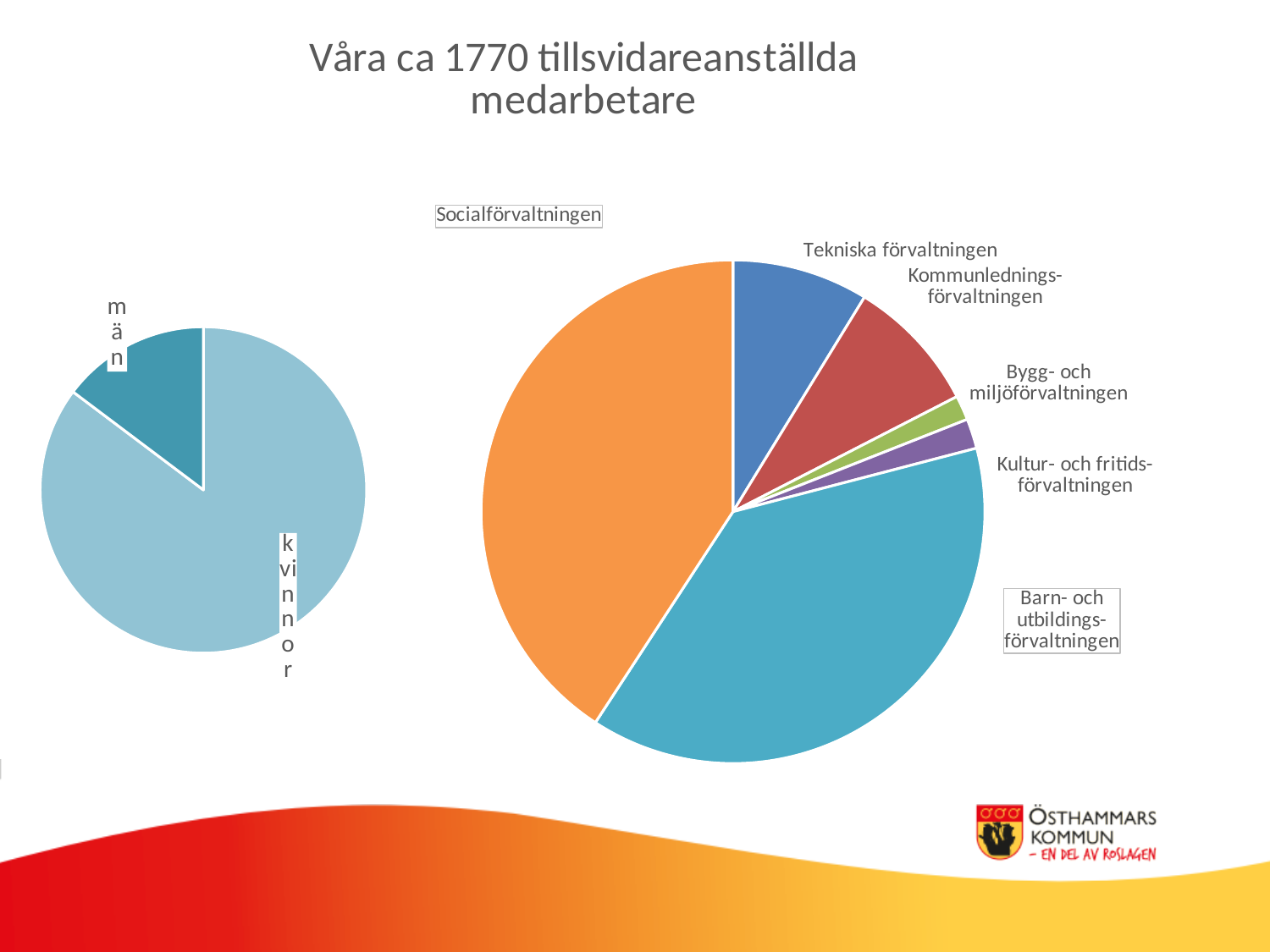
In the large pie chart on the right, what colour is the Socialförvaltningen slice? Orange In the large pie chart on the right, which category has the largest slice? Socialförvaltningen In the small pie chart on the left, which category has the smaller slice? män What kind of chart is the large chart on the right of the slide? Pie chart In the small pie chart on the left, how many slices are shown? 2 In the small pie chart on the left, which category has the larger slice? kvinnor In the large pie chart on the right, which is larger: Socialförvaltningen or Barn- och utbildingsförvaltningen? Socialförvaltningen What kind of chart is the small chart on the left of the slide? Pie chart What is the title of the slide? Våra ca 1770 tillsvidareanställda medarbetare In the large pie chart on the right, how many slices (categories) are shown? 6 In the large pie chart on the right, which is larger: Barn- och utbildingsförvaltningen or Kommunledningsförvaltningen? Barn- och utbildingsförvaltningen In the large pie chart on the right, which is larger: Tekniska förvaltningen or Bygg- och miljöförvaltningen? Tekniska förvaltningen